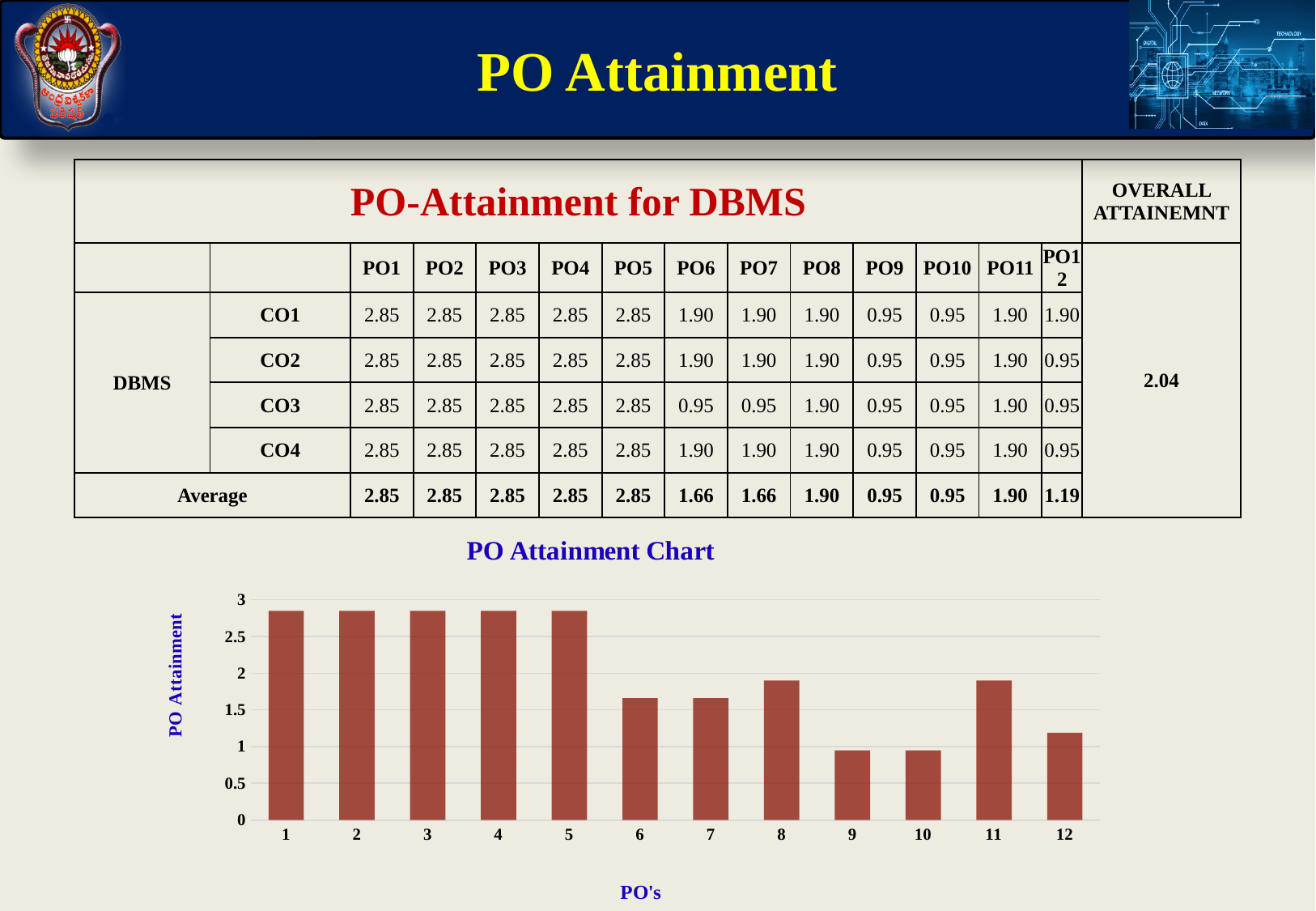
In the PO Attainment Chart, is the value for PO 1 greater or less than 2.5? greater What kind of chart is the PO Attainment Chart? bar chart In the PO Attainment Chart, which has the larger value, PO 11 or PO 12? PO 11 In the PO Attainment Chart, is the value for PO 8 greater or less than 1.5? greater What is the title of the y axis in the PO Attainment Chart? PO Attainment How many PO categories are plotted along the x axis of the PO Attainment Chart? 12 In the PO Attainment Chart, which has the larger value, PO 6 or PO 8? PO 8 In the PO Attainment Chart, is the value for PO 6 greater or less than 2? less What is the title of the x axis in the PO Attainment Chart? PO's In the PO Attainment Chart, do the values rise or fall from PO 8 to PO 9? fall